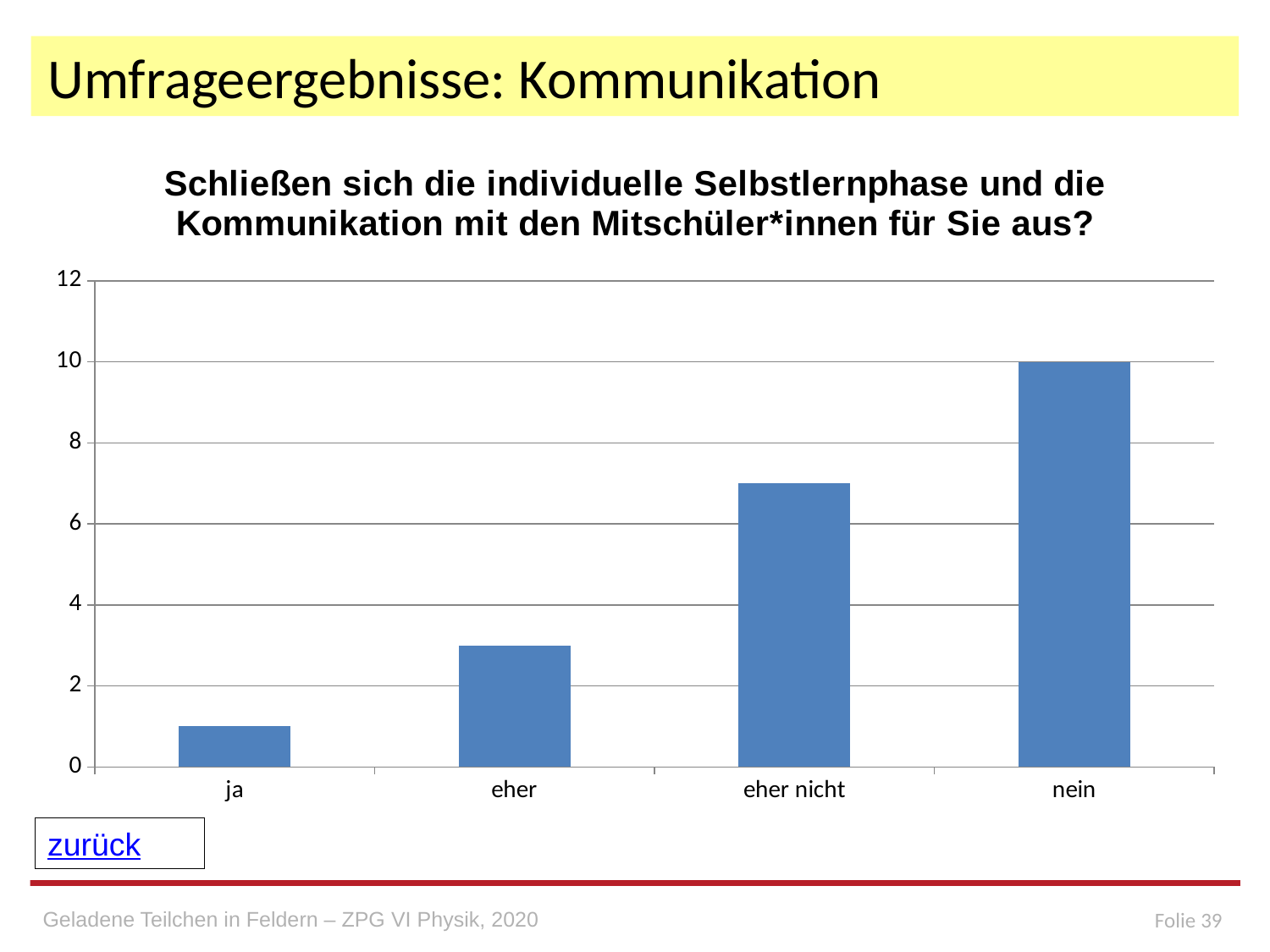
Is the value for "eher nicht" greater or less than 6? greater What is the highest tick value shown on the vertical axis? 12 What is the value for "nein"? 10 Which category has the lowest value? ja Which has the larger value, "eher" or "eher nicht"? eher nicht What kind of chart is shown on the slide? bar chart What is the title of the chart? Schließen sich die individuelle Selbstlernphase und die Kommunikation mit den Mitschüler*innen für Sie aus? Do the values rise or fall from left to right along the x axis? rise How many categories are shown on the x axis of the chart? 4 Is the value for "eher" greater or less than 4? less Is the value for "ja" greater or less than 2? less Which category has the highest value? nein